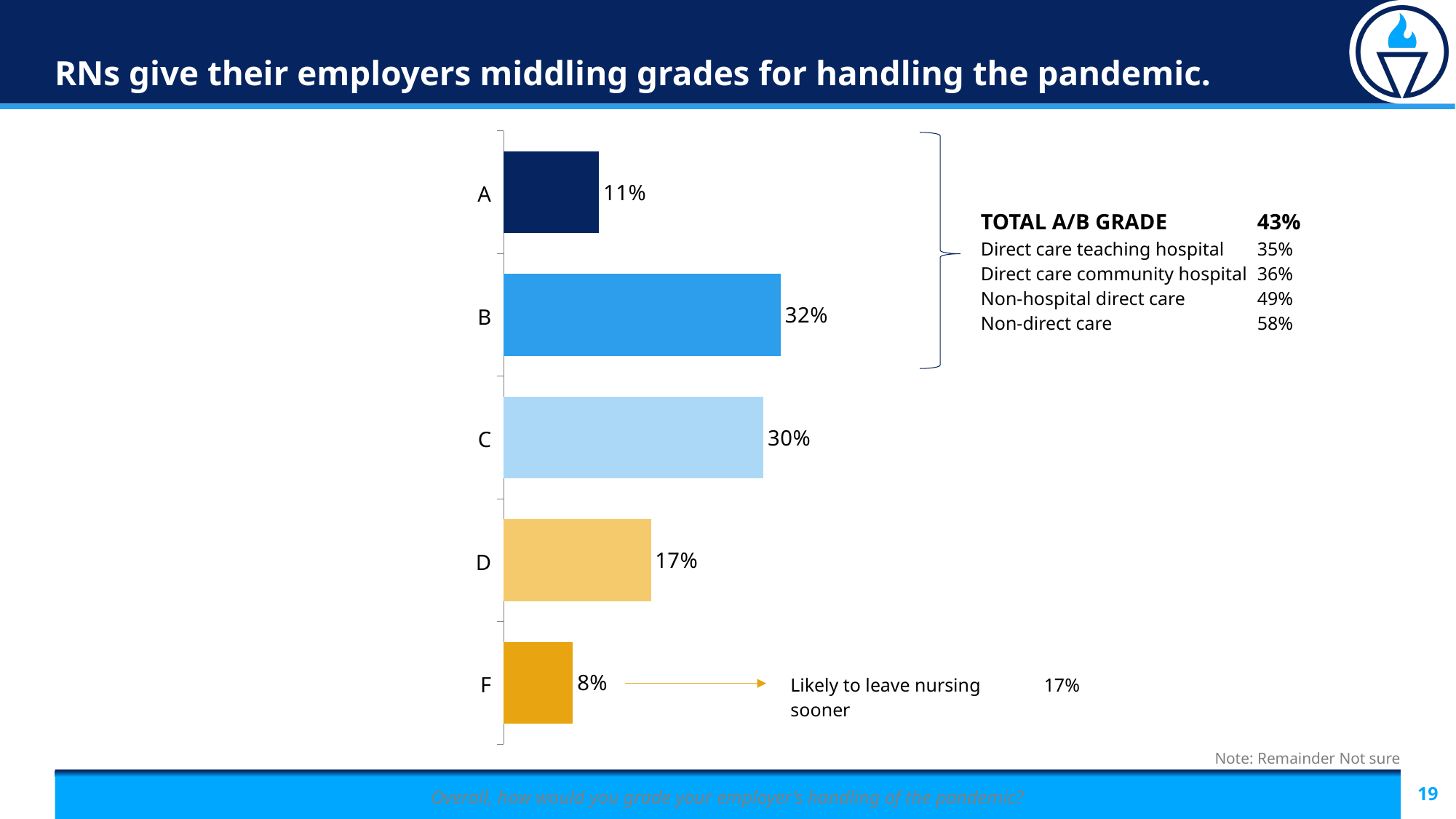
What percentage of RNs gave their employer a grade of A? 11% Which grade was given by the smallest share of RNs? F What percentage of RNs gave their employer a grade of C? 30% Which grade was given by the largest share of RNs? B What percentage of RNs gave their employer a grade of D? 17% What type of chart is used to show the grade distribution? Bar chart What is the difference in percentage points between the share giving a grade of D and the share giving a grade of F? 9 What percentage of RNs gave their employer a grade of F? 8% Which grade was given by more RNs, A or D? D What percentage of RNs gave their employer a grade of B? 32% What is the combined percentage of RNs giving an A or B grade, as shown in the annotation? 43% How many grade categories are shown in the bar chart? 5